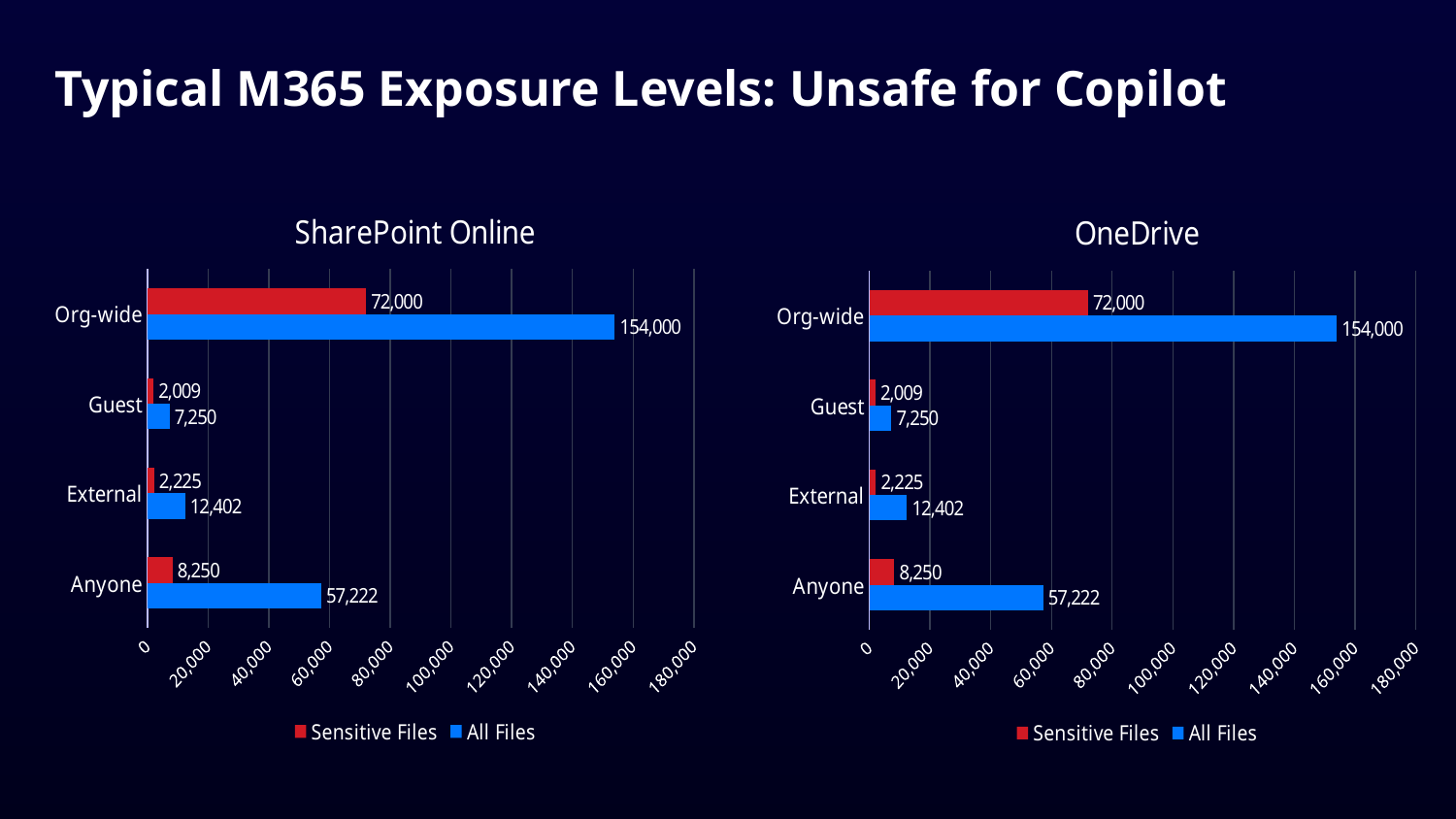
In the OneDrive chart, what is the value for Sensitive Files for Guest? 2,009 How many series does the legend of the SharePoint Online chart list? 2 In the SharePoint Online chart, what is the value for All Files for External? 12,402 In the SharePoint Online chart, what is the difference between All Files and Sensitive Files for Org-wide? 82,000 What type of chart is the OneDrive chart? Bar chart In the SharePoint Online chart, what is the value for All Files for Org-wide? 154,000 In the OneDrive chart, what is the value for Sensitive Files for Anyone? 8,250 In the OneDrive chart, what is the difference between All Files for Anyone and All Files for External? 44,820 In the SharePoint Online chart, which is larger: All Files for Guest or All Files for External? All Files for External How many categories are shown in the OneDrive chart? 4 In the SharePoint Online chart, which category has the highest All Files value? Org-wide In the OneDrive chart, which category has the lowest Sensitive Files value? Guest